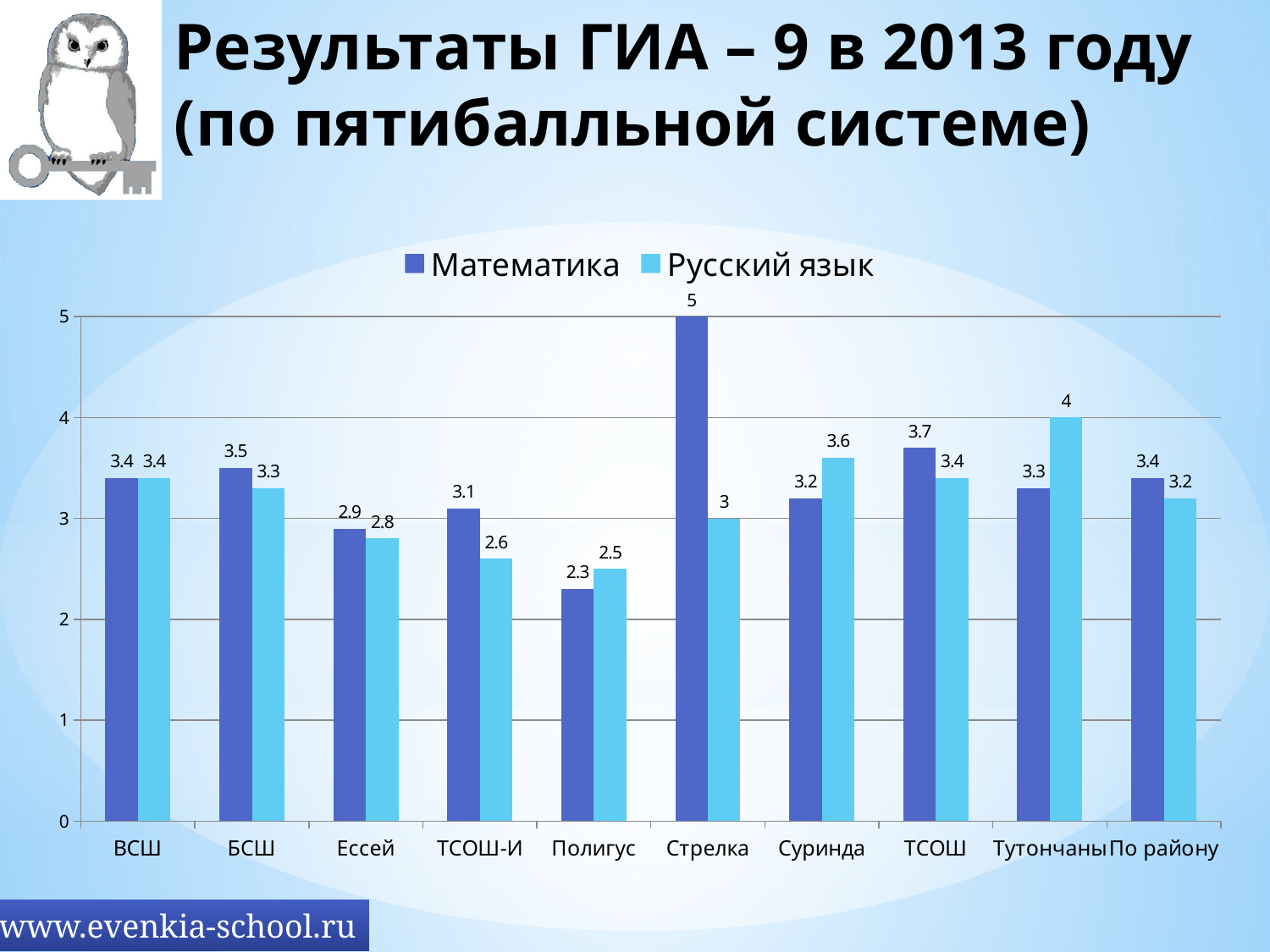
Is the Русский язык value for ТСОШ-И greater or less than 3? less Which is larger for Суринда: the Математика value or the Русский язык value? Русский язык Which category has the lowest Русский язык value? Полигус What is the difference between the Математика and Русский язык values for Стрелка? 2 How many categories are shown on the x axis? 10 What is the Математика value for Стрелка? 5 What is the Русский язык value for Тутончаны? 4 How many series does the legend list? 2 What is the Математика value for Полигус? 2.3 What kind of chart is shown on the slide? bar chart What is the Русский язык value for По району? 3.2 Which category has the highest Математика value? Стрелка